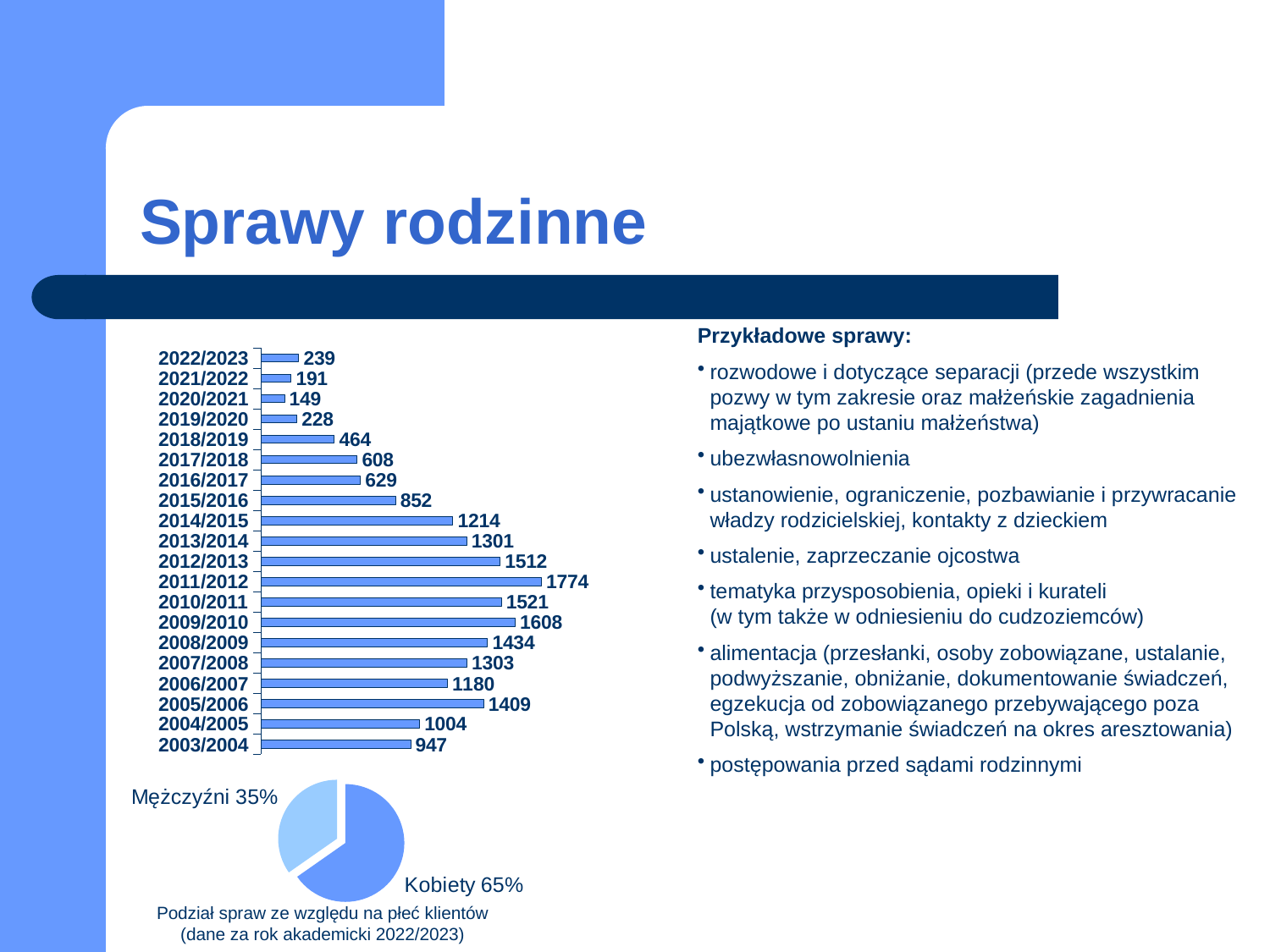
In the bar chart on the left, which academic year has the highest value? 2011/2012 In the pie chart at the bottom left, which group has the larger share: Kobiety or Mężczyźni? Kobiety In the bar chart on the left, what is the value for 2003/2004? 947 In the bar chart on the left, which academic year has the lowest value? 2020/2021 How many academic years are shown in the bar chart on the left? 20 In the pie chart at the bottom left, what share of cases is for Kobiety? 65% In the bar chart on the left, what is the value for 2022/2023? 239 What kind of chart is the chart at the top left of the slide? bar chart In the bar chart on the left, which is larger: the value for 2015/2016 or the value for 2016/2017? 2015/2016 In the bar chart on the left, what is the value for 2011/2012? 1774 In the bar chart on the left, what is the difference between the highest value (2011/2012) and the lowest value (2020/2021)? 1625 In the bar chart on the left, what is the difference between the values for 2022/2023 and 2021/2022? 48